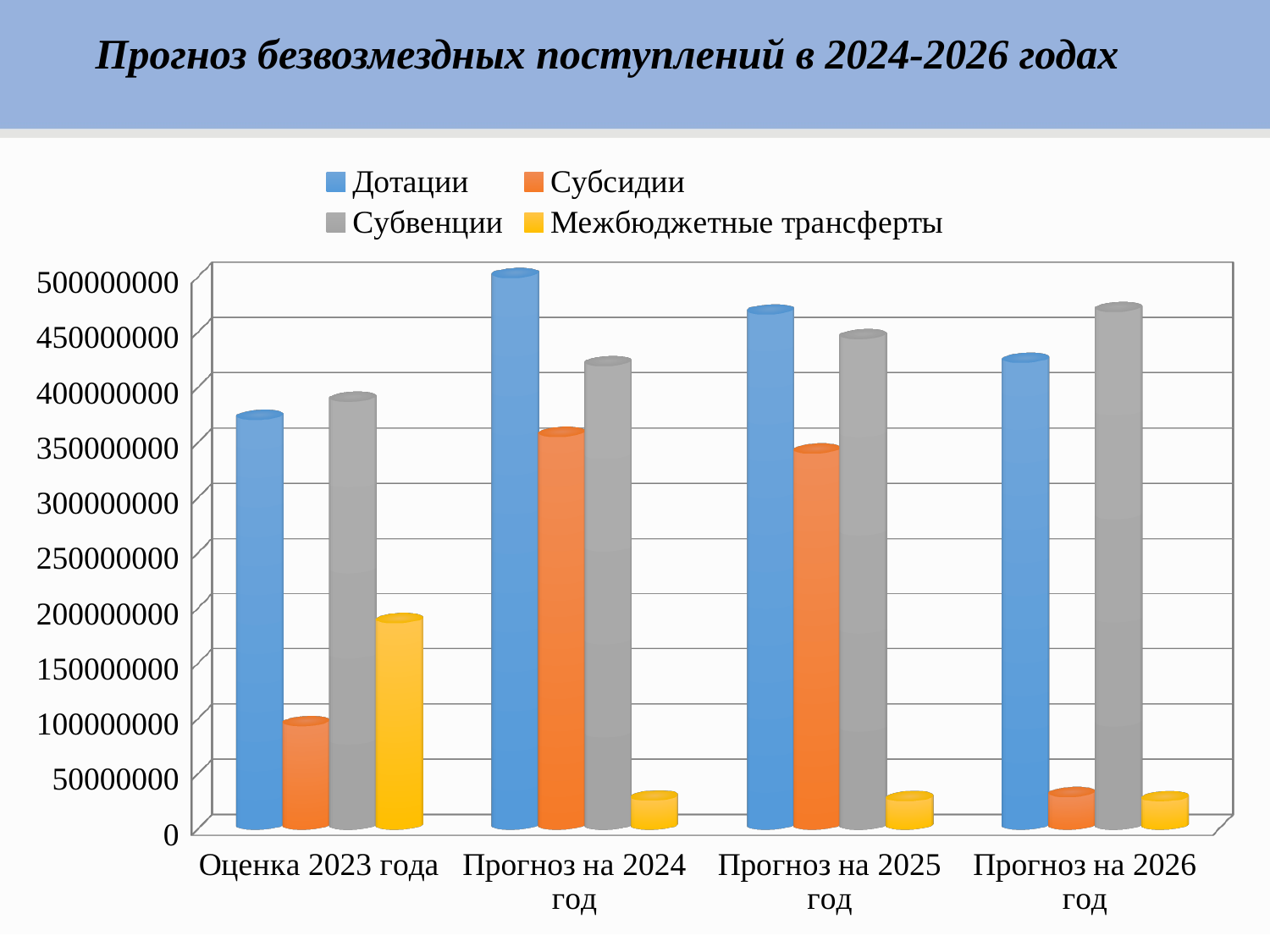
Which series has the lowest value in Прогноз на 2024 год? Межбюджетные трансферты Is the value for Межбюджетные трансферты in Оценка 2023 года greater or less than 150000000? greater How many categories are shown along the x axis? 4 In which category is the value for Дотации the highest? Прогноз на 2024 год What kind of chart is shown on the slide? bar chart In Прогноз на 2026 год, which is larger: Дотации or Субвенции? Субвенции What is the title of the slide? Прогноз безвозмездных поступлений в 2024-2026 годах How many series does the legend list? 4 Is the value for Субсидии in Оценка 2023 года greater or less than 150000000? less Is the value for Дотации in Прогноз на 2024 год greater or less than 450000000? greater In Оценка 2023 года, which is larger: Субсидии or Межбюджетные трансферты? Межбюджетные трансферты Do the values for Субвенции rise or fall from Оценка 2023 года to Прогноз на 2026 год? rise